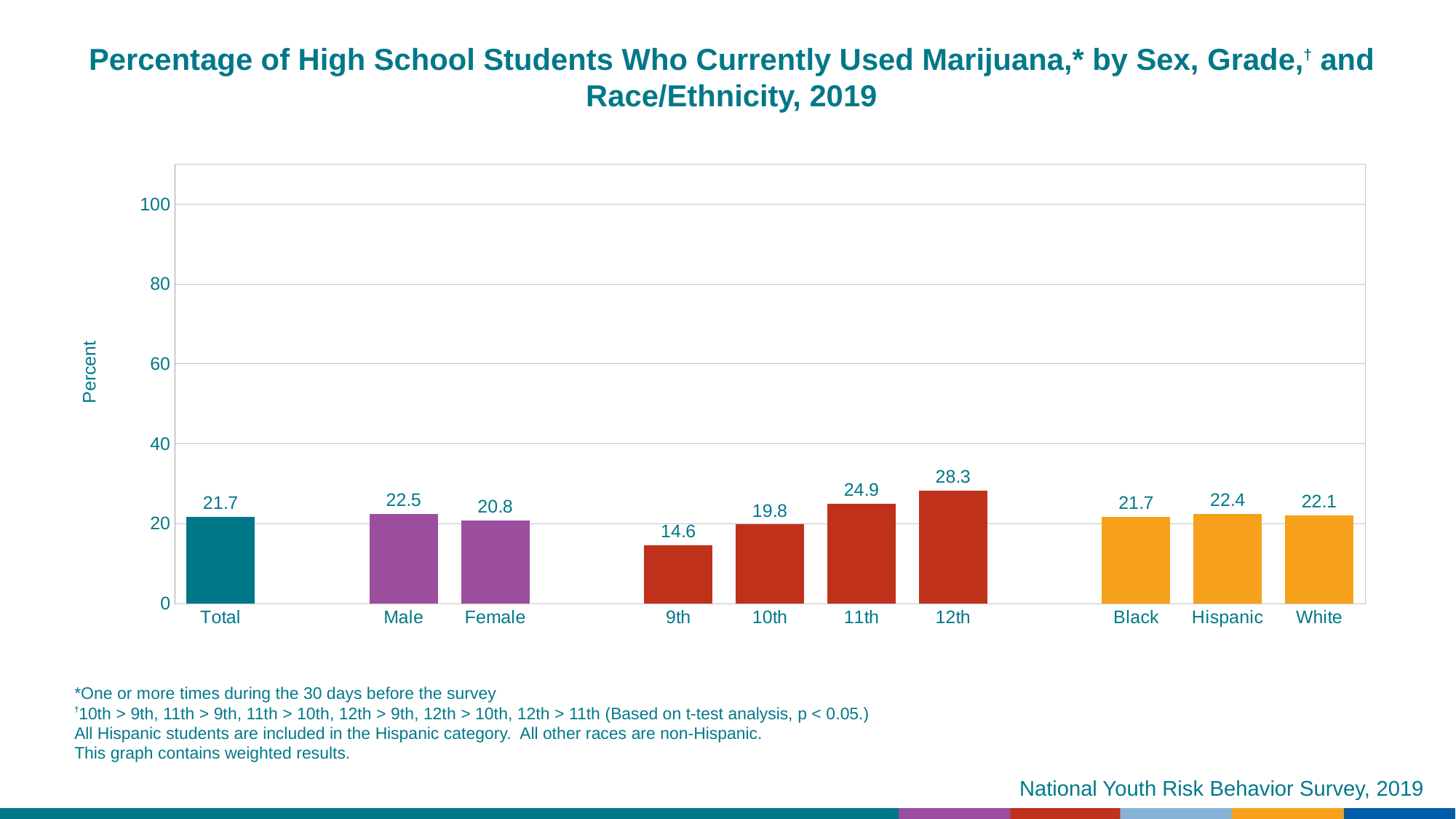
Which category has the lowest value? 9th Is the value for 9th grade greater or less than 20? less Do the values rise or fall from 9th grade to 12th grade? rise Which category has the highest value? 12th What kind of chart is this? bar chart What is the difference between the values for Male and Female? 1.7 How many categories are shown on the x axis? 10 What is the difference between the values for 12th and 9th grade? 13.7 Which is larger, the value for 11th grade or the value for 10th grade? 11th What is the value for Total? 21.7 What is the value for 12th grade? 28.3 What is the value for Hispanic students? 22.4